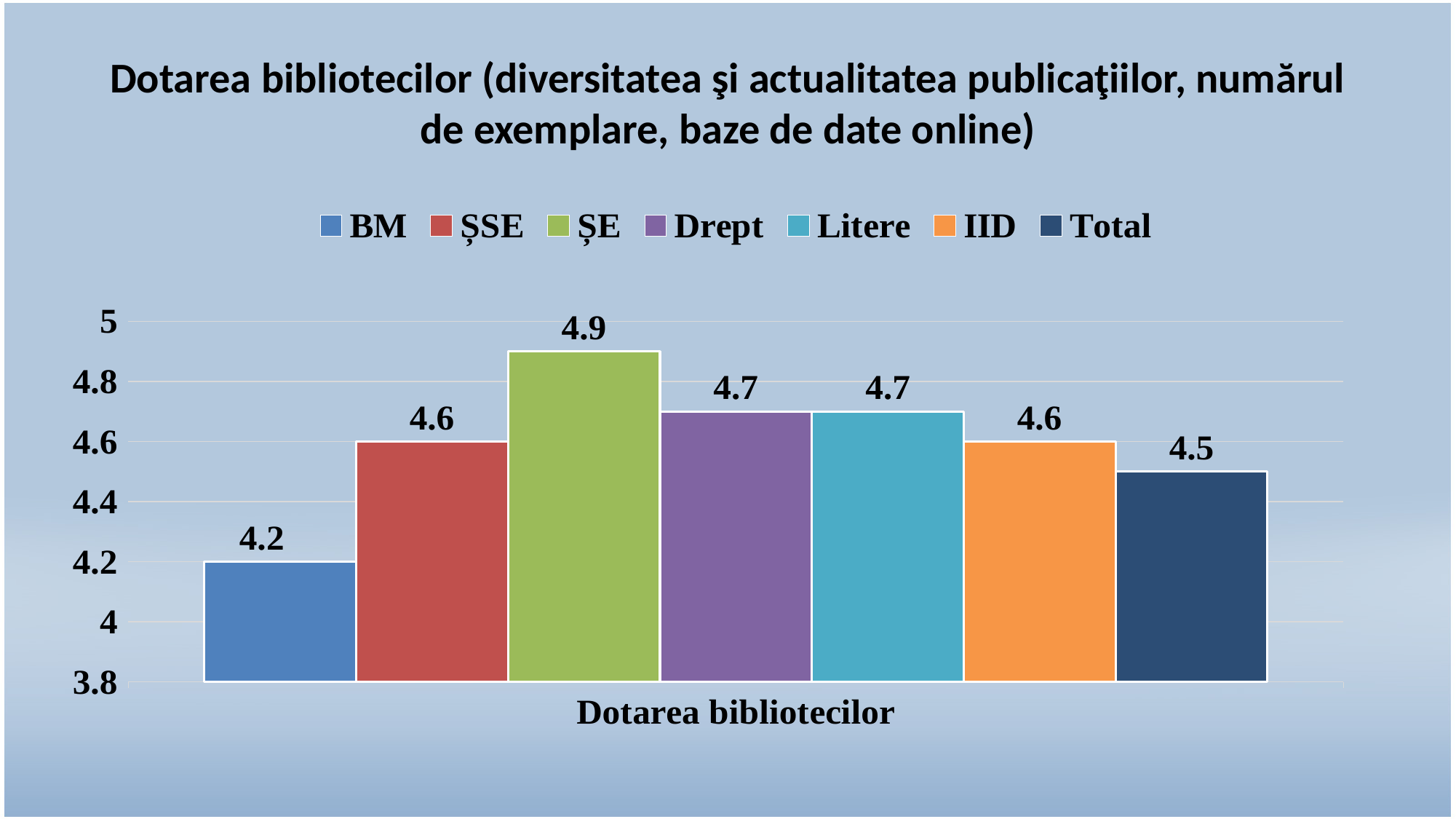
What kind of chart is shown on the slide? Bar chart What is the difference between the values for Drept and Total? 0.2 Which series has the lowest value? BM What is the difference between the values for ȘE and BM? 0.7 How many series does the legend list? 7 What is the label shown on the x axis below the bars? Dotarea bibliotecilor What is the value for ȘE? 4.9 What is the value for Total? 4.5 What is the value for IID? 4.6 What is the value for BM? 4.2 Which is larger, the value for ȘSE or the value for Litere? Litere Which series has the highest value? ȘE